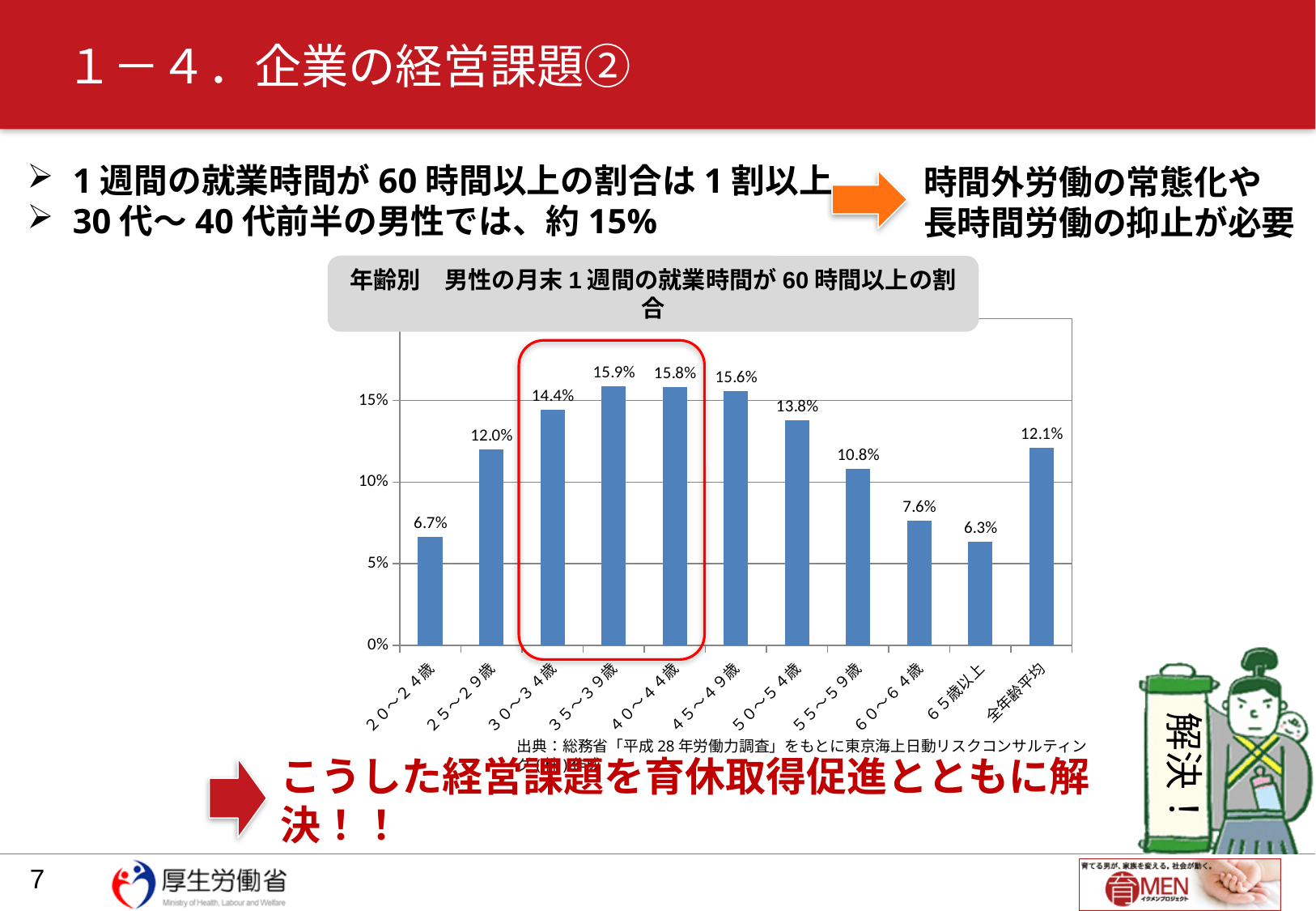
Which is larger, the value for 25～29歳 or the value for 50～54歳? 50～54歳 Which category has the lowest value in the chart? 65歳以上 Is the value for 60～64歳 greater or less than 10%? less What is the value for 全年齢平均 in the chart? 12.1% What type of chart is shown on the slide? bar chart What is the value for 35～39歳 in the chart? 15.9% What is the difference between the values for 30～34歳 and 20～24歳? 7.7% Do the values rise or fall from 45～49歳 to 65歳以上? fall Which age group has the highest value in the chart? 35～39歳 What is the value for 20～24歳 in the chart? 6.7% How many categories are shown on the x axis of the chart? 11 What is the value for 55～59歳 in the chart? 10.8%